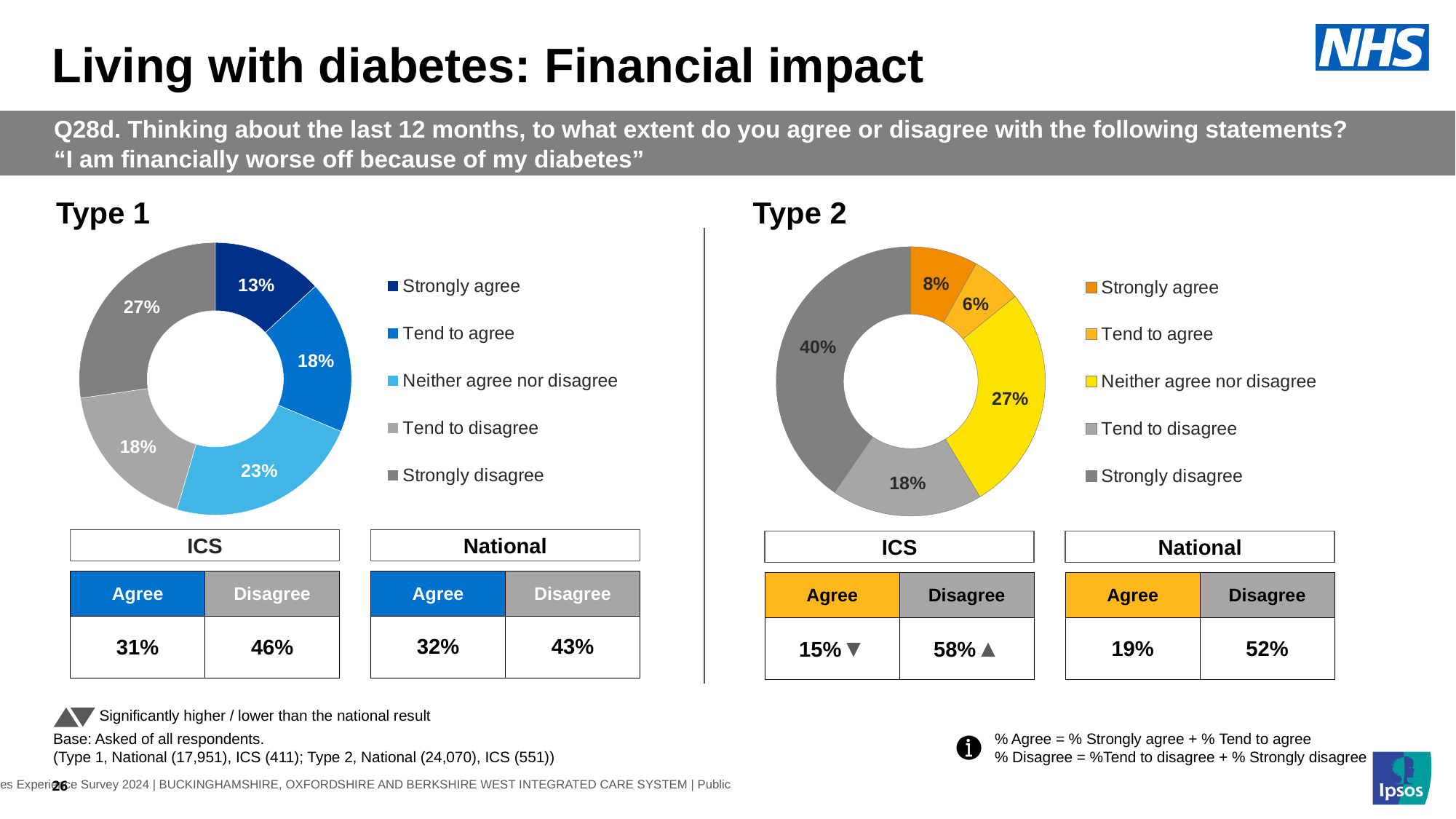
What kind of chart is used to show the Type 1 results? Donut chart In the Type 2 chart, what is the difference between the Strongly disagree share and the Neither agree nor disagree share? 13% In the Type 1 chart, which response category has the largest share? Strongly disagree In the Type 1 chart, what is the combined share of Strongly agree and Tend to agree? 31% In the Type 1 chart, what percentage of respondents said they neither agree nor disagree? 23% In the Type 2 chart, what percentage of respondents said they strongly disagree? 40% How many response categories does the legend of the Type 2 chart list? 5 In the Type 2 chart, what percentage of respondents said they tend to agree? 6% In the Type 1 chart, which is larger: the Tend to agree share or the Neither agree nor disagree share? Neither agree nor disagree In the Type 2 chart, what colour is the Neither agree nor disagree segment? Yellow In the Type 1 chart, what percentage of respondents said they strongly agree? 13% In the Type 2 chart, which response category has the smallest share? Tend to agree